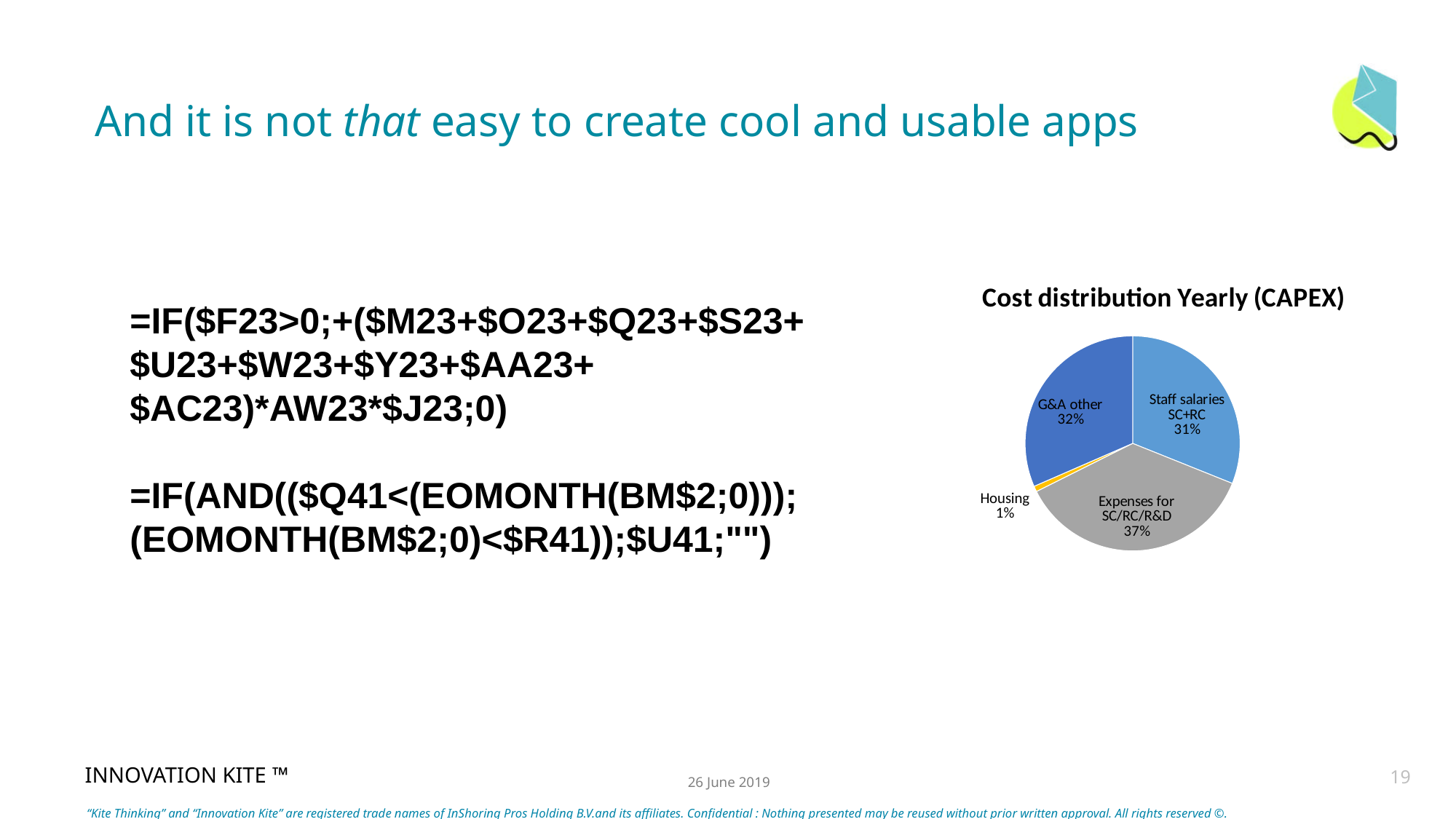
What colour is the Expenses for SC/RC/R&D slice? Grey How many categories are shown in the pie chart? 4 What share of the pie is G&A other? 32% What is the difference in percentage points between Expenses for SC/RC/R&D and Staff salaries SC+RC? 6 Which category has the smallest slice of the pie? Housing What is the title of the chart? Cost distribution Yearly (CAPEX) Which category has the largest slice of the pie? Expenses for SC/RC/R&D Which is larger, the share for G&A other or the share for Housing? G&A other What share of the pie is Expenses for SC/RC/R&D? 37% What share of the pie is Housing? 1% What kind of chart is shown on the slide? Pie chart